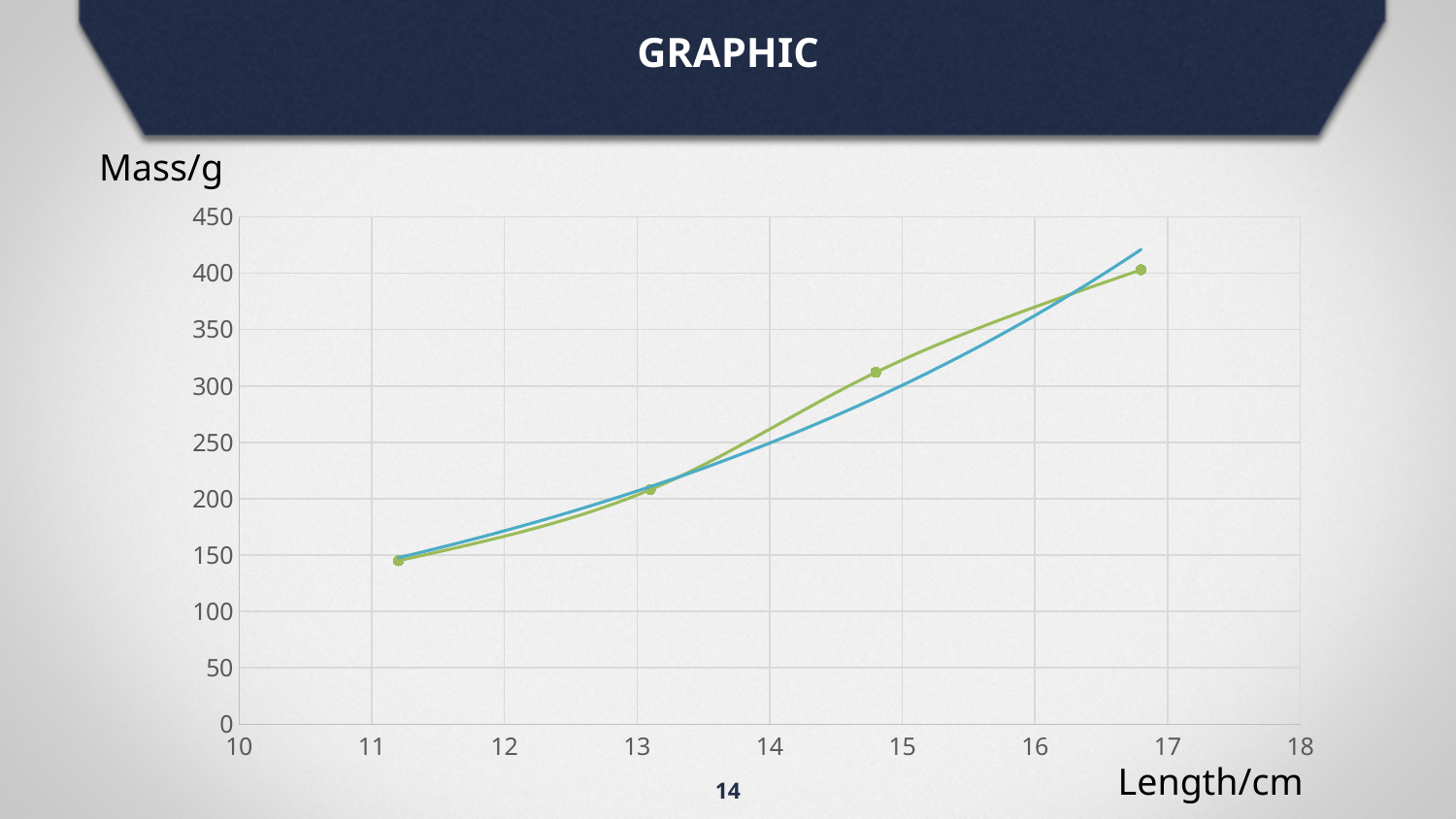
Is the mass value of the leftmost data point greater or less than 200? less What is the label of the vertical axis? Mass/g How many data points are plotted on the green series? 4 Is the mass value of the data point near a length of 15 cm greater or less than 300? greater Do the mass values rise or fall as length increases along the x axis? rise Is the mass value of the data point near a length of 13 cm greater or less than 250? less Which data point has the highest mass: the leftmost or the rightmost? the rightmost What is the label of the horizontal axis? Length/cm What kind of chart is shown on the slide? line chart What is the maximum value shown on the vertical axis? 450